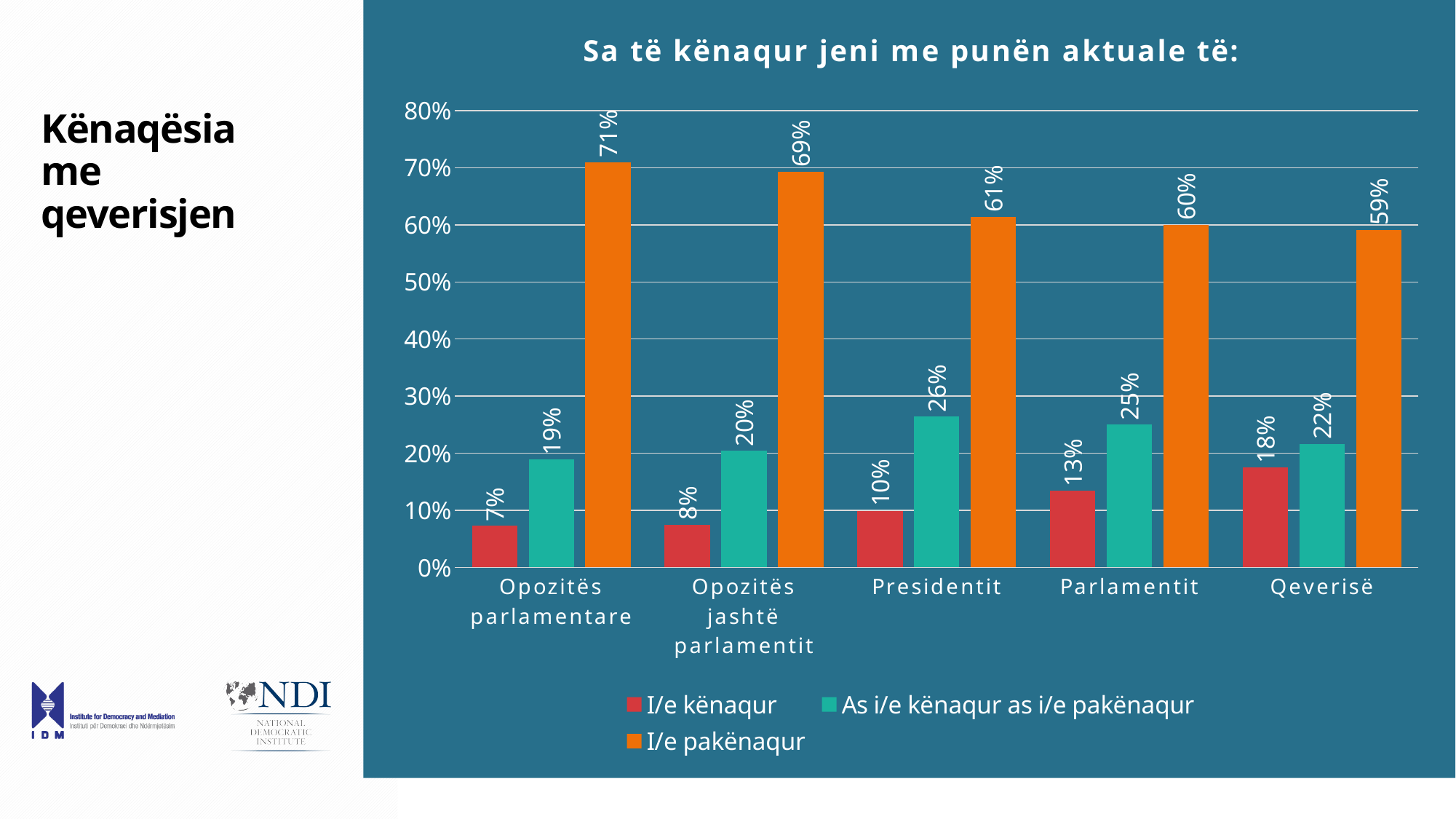
What kind of chart is shown on the slide? bar chart What is the value of 'I/e pakënaqur' for Opozitës parlamentare? 71% What is the value of 'As i/e kënaqur as i/e pakënaqur' for Presidentit? 26% What is the title of the chart? Sa të kënaqur jeni me punën aktuale të: Is the 'I/e pakënaqur' value for Presidentit greater or less than 50%? greater Which category has the lowest 'I/e kënaqur' value? Opozitës parlamentare How many series does the legend list? 3 What is the difference between the 'I/e pakënaqur' values for Opozitës parlamentare and Qeverisë? 12% Which category has the highest 'I/e pakënaqur' value? Opozitës parlamentare Which is larger: the 'I/e kënaqur' value for Parlamentit or for Qeverisë? Qeverisë How many categories are shown on the x axis? 5 What is the value of 'I/e kënaqur' for Qeverisë? 18%